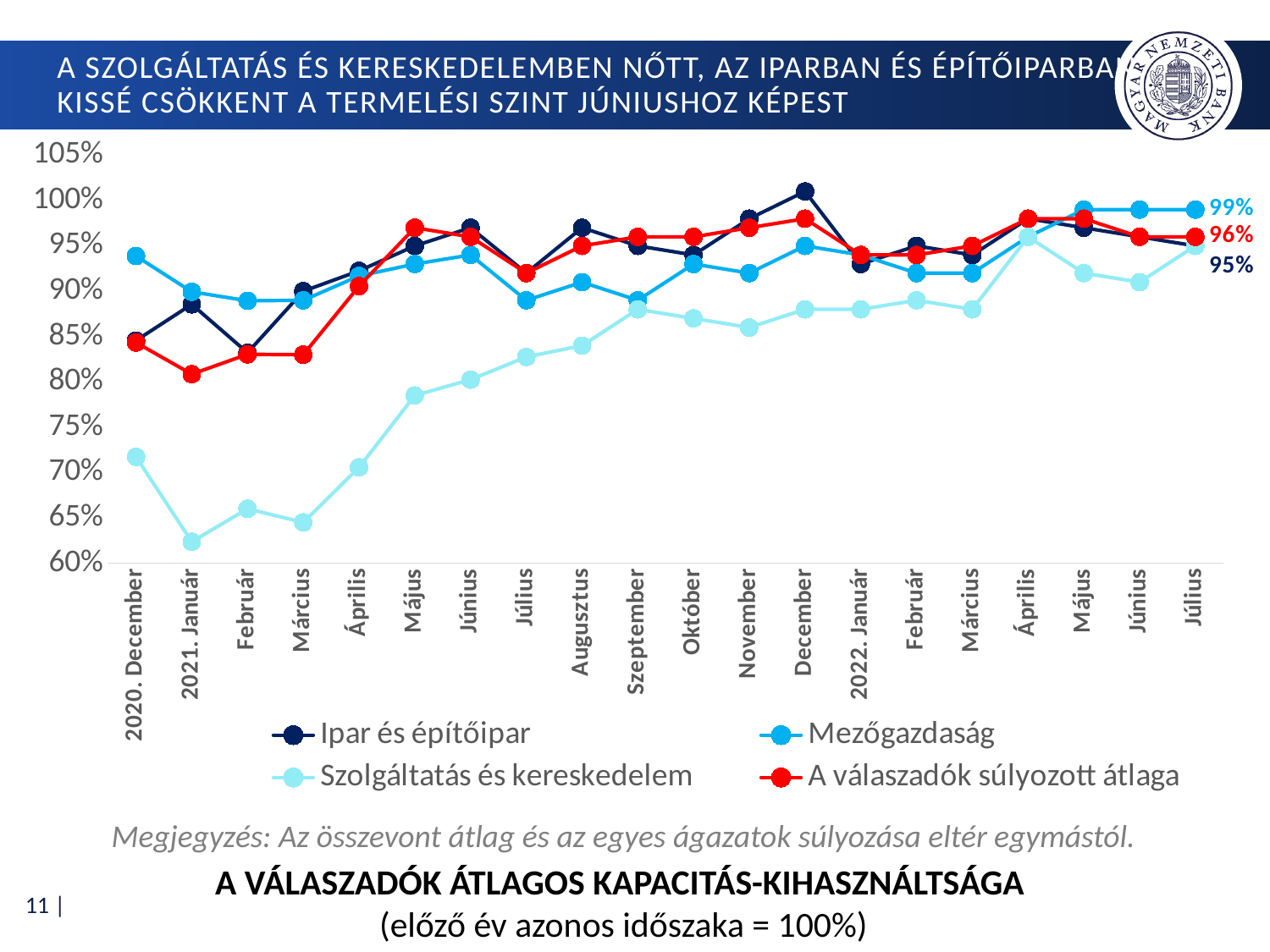
In which month does the Szolgáltatás és kereskedelem series reach its lowest value? 2021. Január What is the difference between the Mezőgazdaság and Ipar és építőipar values in Július 2022? 4 percentage points Does the Szolgáltatás és kereskedelem series rise or fall between 2021. Január and Április 2022? rise What is the value for Mezőgazdaság in Július 2022? 99% How many series does the legend list? 4 What colour is the line for A válaszadók súlyozott átlaga? red What is the value for A válaszadók súlyozott átlaga in Július 2022? 96% What type of chart is shown on the slide? line chart Is the value for Szolgáltatás és kereskedelem in 2020. December greater or less than 75%? less What is the value for Ipar és építőipar in Július 2022? 95% How many months (points) are shown along the x axis? 20 Which series has the highest value in December 2021? Ipar és építőipar